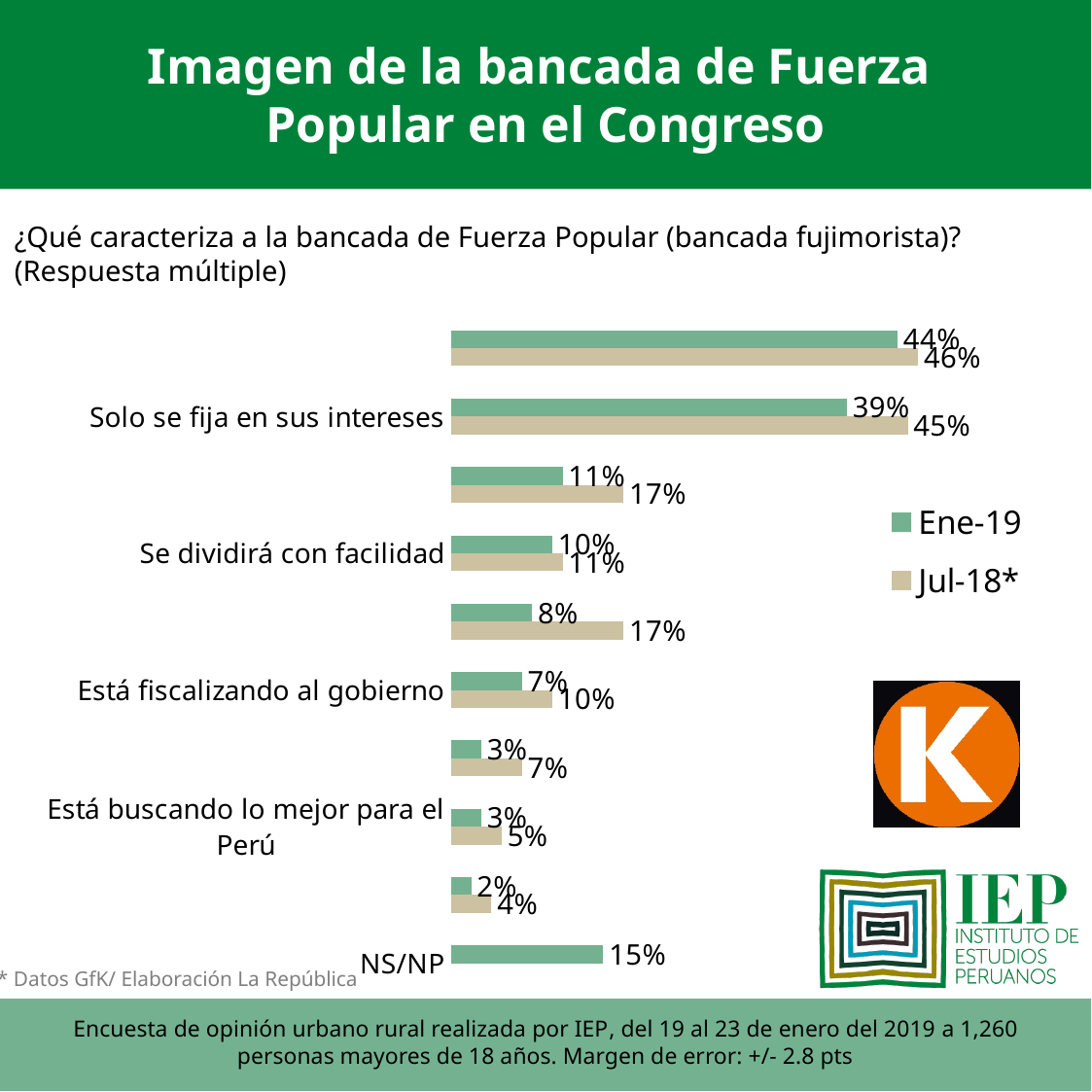
What kind of chart is shown on the slide? Bar chart What is the Ene-19 value for "Solo se fija en sus intereses"? 39% What is the highest Ene-19 value shown on the chart? 44% For "Está fiscalizando al gobierno", which series has the larger value, Ene-19 or Jul-18*? Jul-18* What is the value shown for NS/NP? 15% What is the Ene-19 value for "Está buscando lo mejor para el Perú"? 3% What is the Jul-18* value for "Solo se fija en sus intereses"? 45% What is the Jul-18* value for "Está fiscalizando al gobierno"? 10% What are the two entries in the chart's legend? Ene-19 and Jul-18* What is the Ene-19 value for "Se dividirá con facilidad"? 10% How many series does the legend list? 2 By how many percentage points does the Jul-18* value exceed the Ene-19 value for "Solo se fija en sus intereses"? 6 percentage points